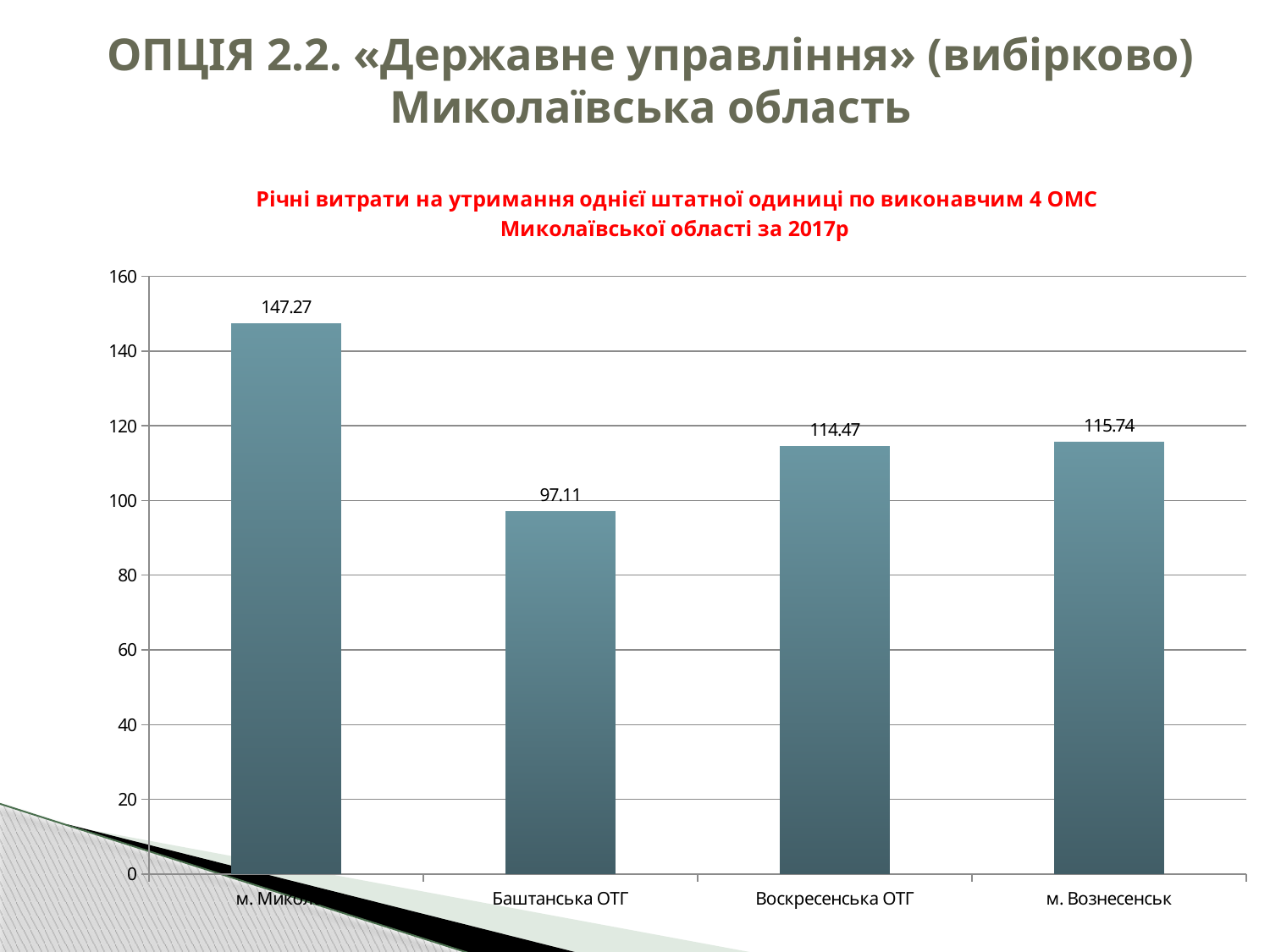
How many bars are shown in the chart? 4 Which is larger, the value for Воскресенська ОТГ or the value for м. Вознесенськ? м. Вознесенськ Is the value for Баштанська ОТГ greater or less than 100? less What is the difference between the values for м. Вознесенськ and Баштанська ОТГ? 18.63 What is the difference between the leftmost bar's value and the value for Баштанська ОТГ? 50.16 What is the value shown on the leftmost bar of the chart? 147.27 What is the value for м. Вознесенськ? 115.74 What is the value for Баштанська ОТГ? 97.11 What is the difference between the values for м. Вознесенськ and Воскресенська ОТГ? 1.27 Which category has the lowest value? Баштанська ОТГ What is the value for Воскресенська ОТГ? 114.47 What kind of chart is shown on the slide? bar chart